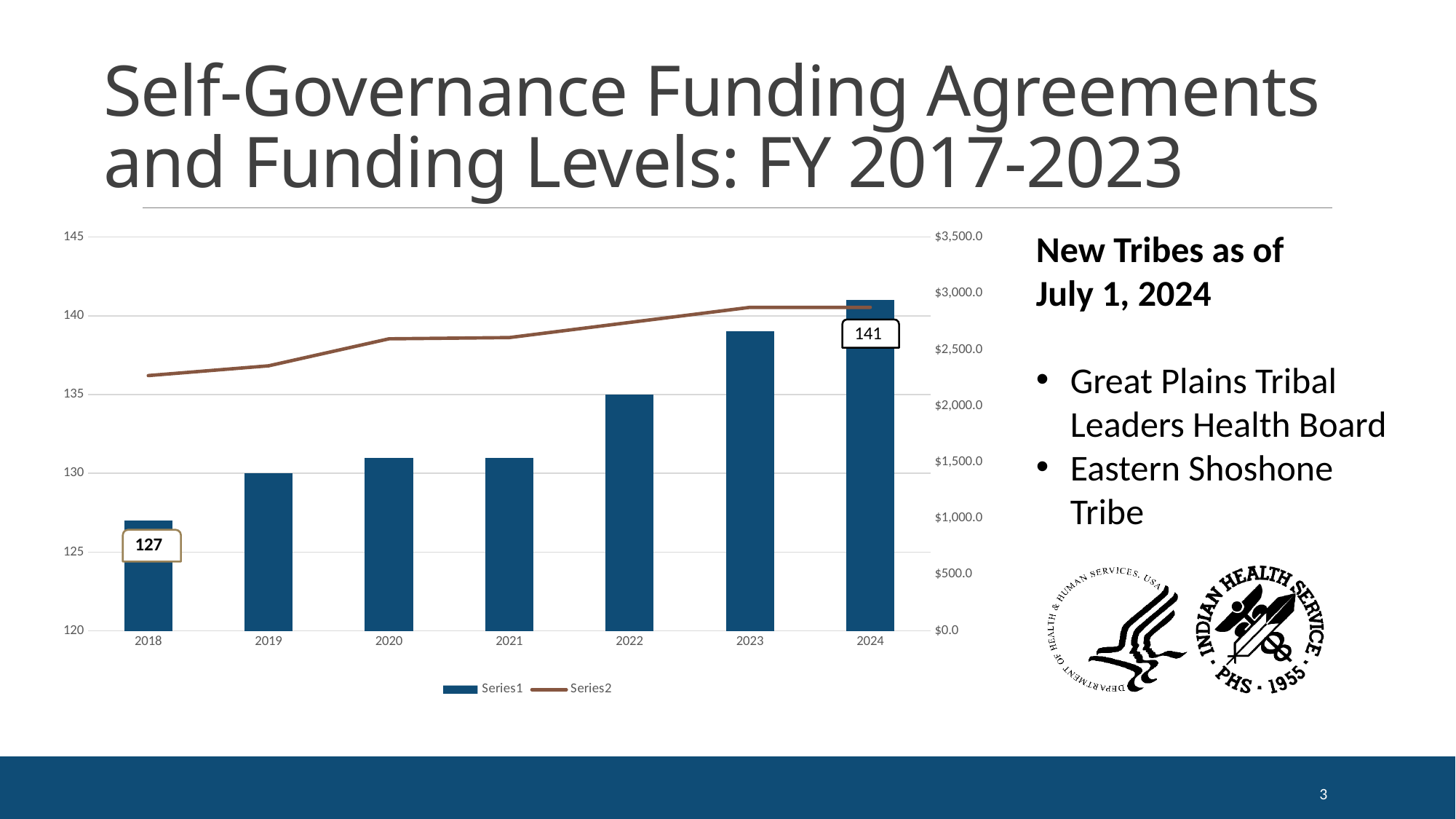
Which year has the highest Series1 bar? 2024 Is the Series1 value for 2021 greater or less than 135? less Is the Series1 value for 2023 greater or less than 135? greater What kind of chart is used for Series1? bar chart How many series does the legend list? 2 What is the difference between the Series1 values for 2024 and 2018? 14 How many years are shown on the x axis? 7 What is the Series1 value for 2018? 127 Which is larger, the Series1 bar for 2023 or for 2020? 2023 What is the Series1 value for 2024? 141 Do the Series1 bars generally rise or fall from 2018 to 2024? rise Which year has the lowest Series1 bar? 2018